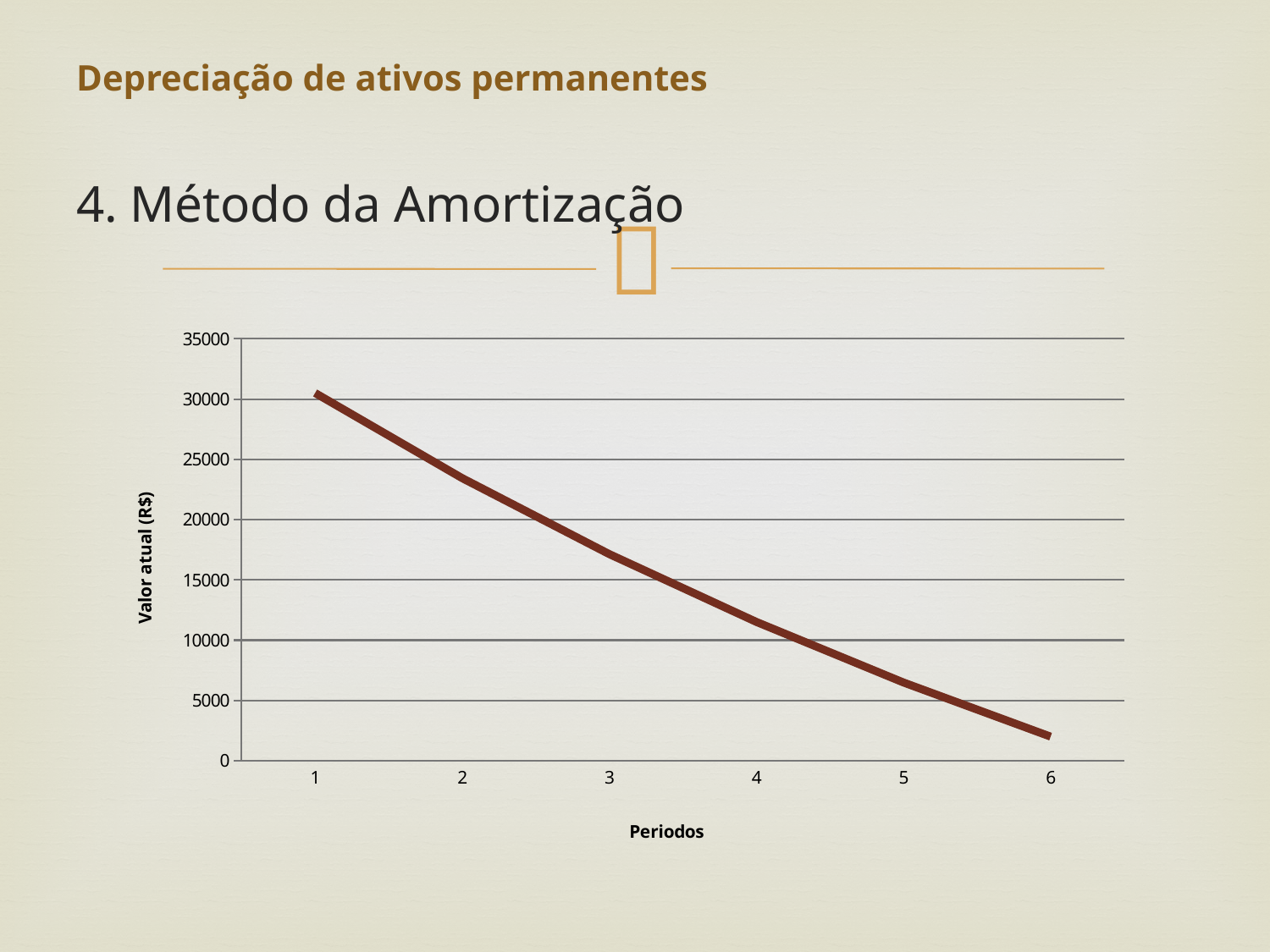
Is the value for period 3 greater or less than 20000? less Which is larger, the value for period 2 or the value for period 5? period 2 Is the value for period 6 greater or less than 5000? less What is the title of the vertical axis? Valor atual (R$) Do the values rise or fall as the period increases from 1 to 6? fall Is the value for period 4 greater or less than 10000? greater What kind of chart is shown on the slide? line chart Which period has the highest value? 1 How many periods are plotted on the x axis? 6 What is the title of the horizontal axis? Periodos Which period has the lowest value? 6